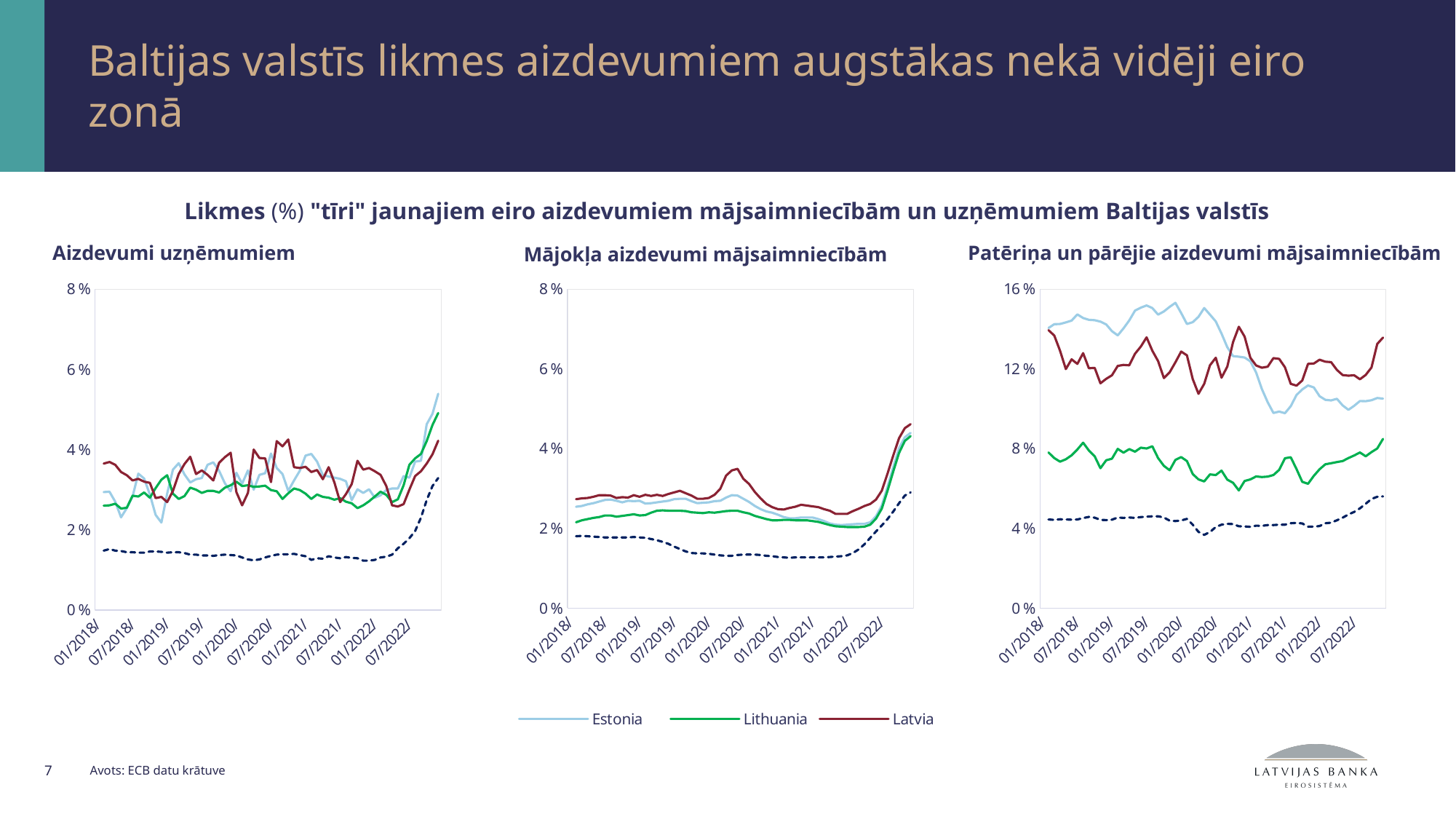
In the right chart "Patēriņa un pārējie aizdevumi mājsaimniecībām", which country has the highest value at the last point (after 07/2022)? Latvia What kind of chart is used in the left chart titled "Aizdevumi uzņēmumiem"? line chart How many series does the shared legend below the charts list? 3 What is the title of the middle chart? Mājokļa aizdevumi mājsaimniecībām In the right chart "Patēriņa un pārējie aizdevumi mājsaimniecībām", is the value for Lithuania at 01/2018 greater or less than 12%? less In the left chart "Aizdevumi uzņēmumiem", is the value for Estonia at the last point (after 07/2022) greater or less than 4%? greater In the middle chart "Mājokļa aizdevumi mājsaimniecībām", do the values for Latvia rise or fall between 01/2022 and the end of the series? rise In the right chart "Patēriņa un pārējie aizdevumi mājsaimniecībām", does the Estonia line overall rise or fall from 01/2018 to the end of the series? fall In the middle chart "Mājokļa aizdevumi mājsaimniecībām", is the value for Latvia at the last point (after 07/2022) greater or less than 4%? greater Which countries are listed in the legend below the charts? Estonia, Lithuania, Latvia